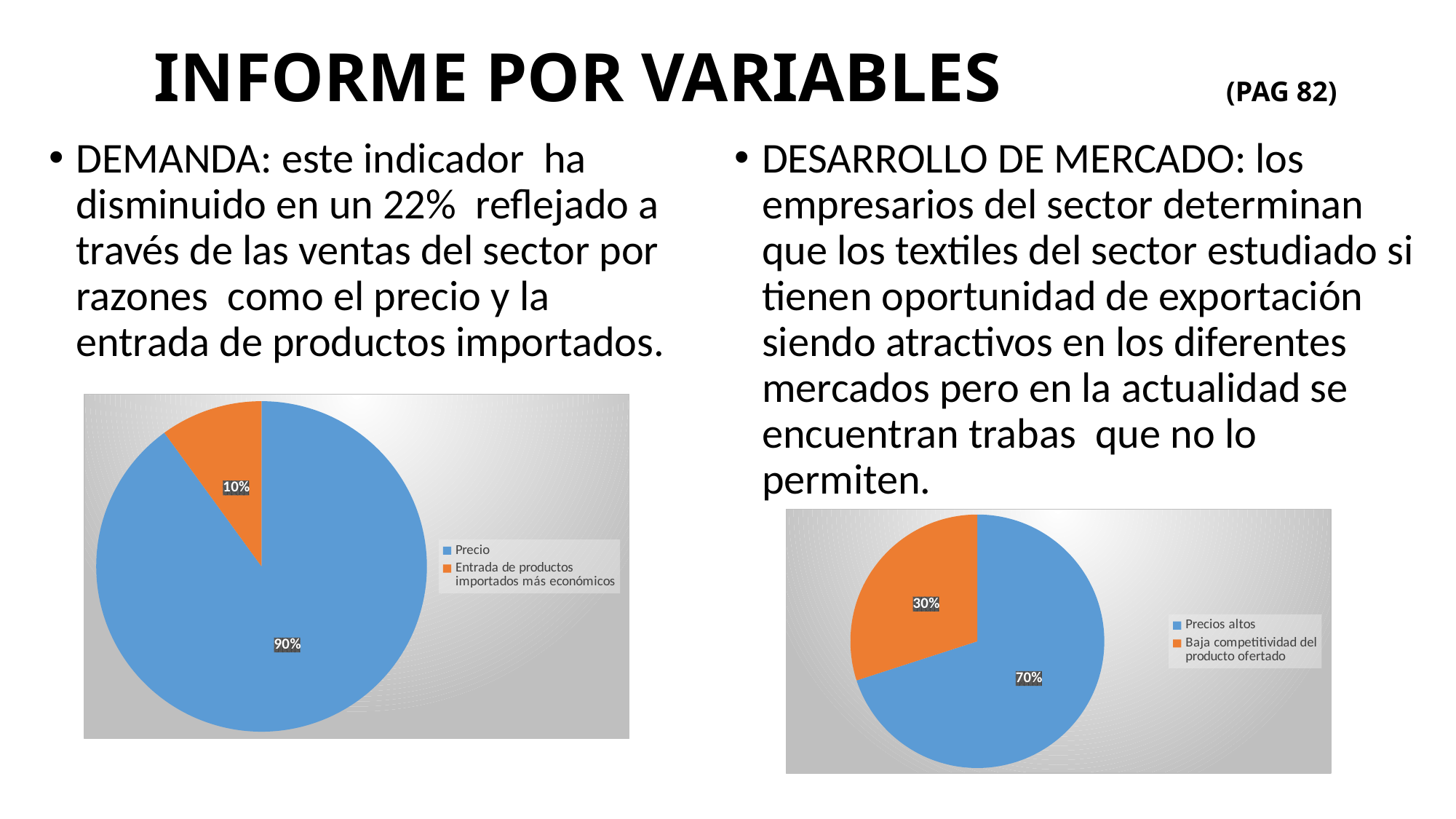
In the pie chart on the right, what is the difference between the Precios altos slice and the Baja competitividad del producto ofertado slice? 40% In the pie chart on the right, which category has the smallest slice? Baja competitividad del producto ofertado In the pie chart on the right, what colour is the Precios altos slice? Blue In the pie chart on the left, which category has the largest slice? Precio What kind of chart is the chart on the left? Pie chart In the pie chart on the left, what is the difference between the Precio slice and the Entrada de productos importados más económicos slice? 80% In the pie chart on the left, what share does Entrada de productos importados más económicos have? 10% In the pie chart on the left, what share does Precio have? 90% In the pie chart on the left, how many slices are there? 2 In the pie chart on the right, which is larger: Precios altos or Baja competitividad del producto ofertado? Precios altos In the pie chart on the right, what share does Precios altos have? 70%